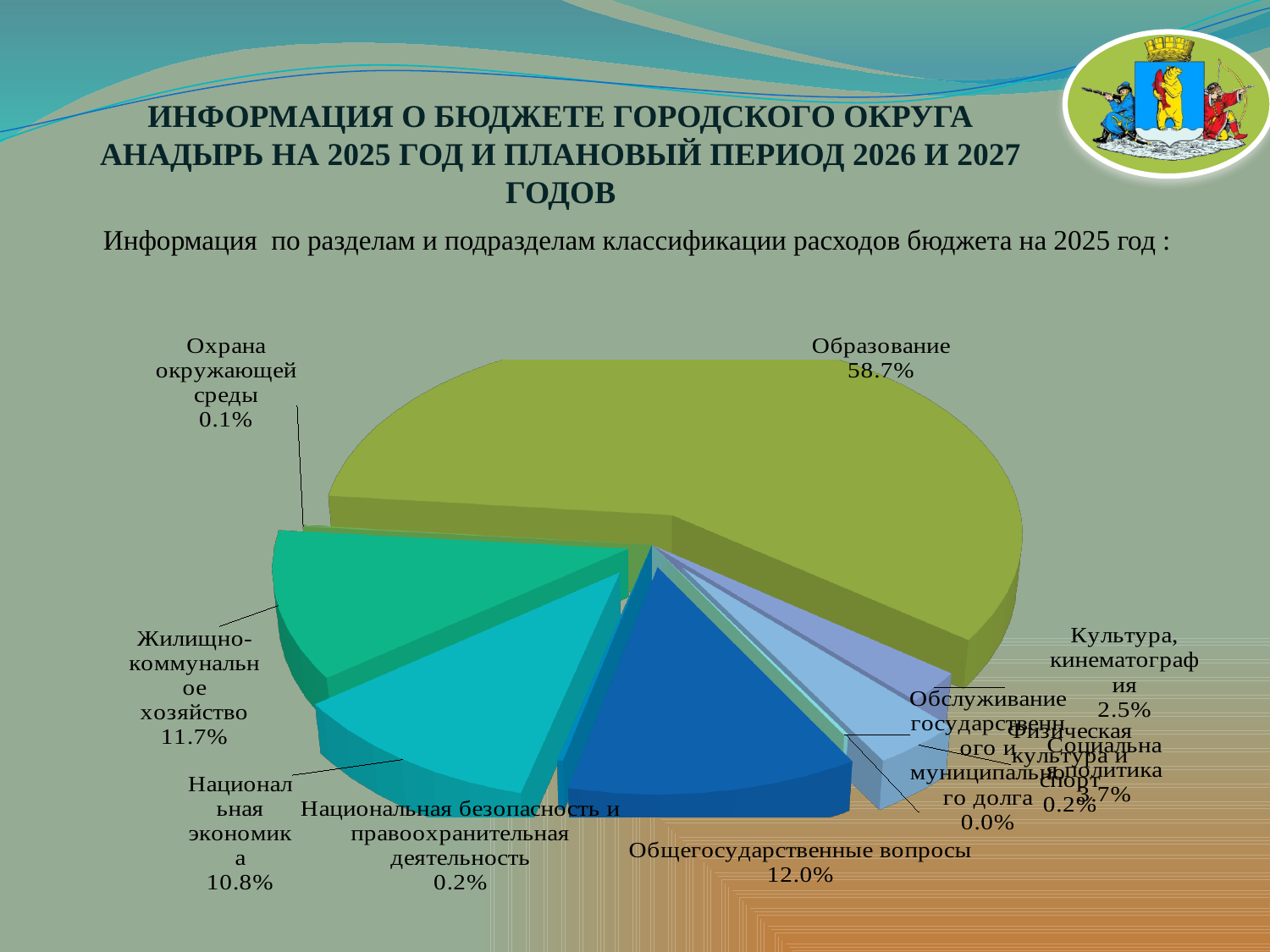
What is the value for Социальная политика? 3.7% What percentage is shown for Жилищно-коммунальное хозяйство? 11.7% What is the difference in percentage points between Общегосударственные вопросы and Жилищно-коммунальное хозяйство? 0.3 How many categories are shown in the pie chart? 10 What is the value shown for Общегосударственные вопросы? 12.0% What is the value for Национальная экономика? 10.8% Which is larger: Жилищно-коммунальное хозяйство or Национальная экономика? Жилищно-коммунальное хозяйство What share is shown for Культура, кинематография? 2.5% What type of chart is shown on the slide? Pie chart Which category has the largest share of the pie? Образование Which category has the smallest share of the pie? Обслуживание государственного и муниципального долга What share of the pie does Образование account for? 58.7%